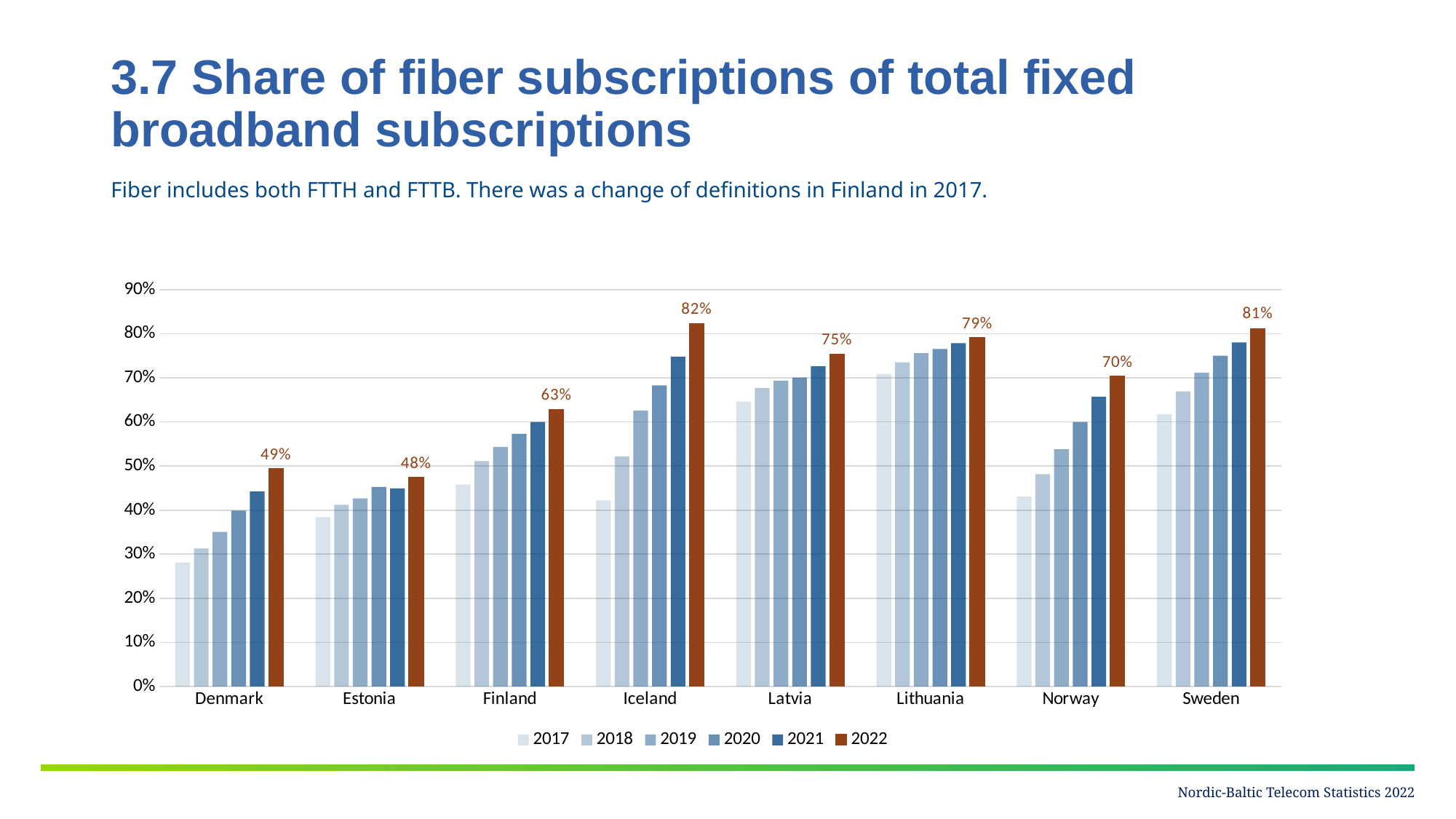
Which country has the lowest 2022 share of fiber subscriptions? Estonia How many countries are shown on the x axis? 8 Which is larger, the 2022 value for Lithuania or the 2022 value for Latvia? Lithuania What is the 2022 share of fiber subscriptions for Iceland? 82% How many series does the legend list? 6 Which country has the highest 2022 share of fiber subscriptions? Iceland Do the values for Finland rise or fall from 2017 to 2022? Rise What kind of chart is shown on the slide? Bar chart What is the 2022 share of fiber subscriptions for Estonia? 48% What is the difference between the 2022 values for Sweden and Denmark? 32 percentage points Is the 2017 value for Denmark greater or less than 30%? less